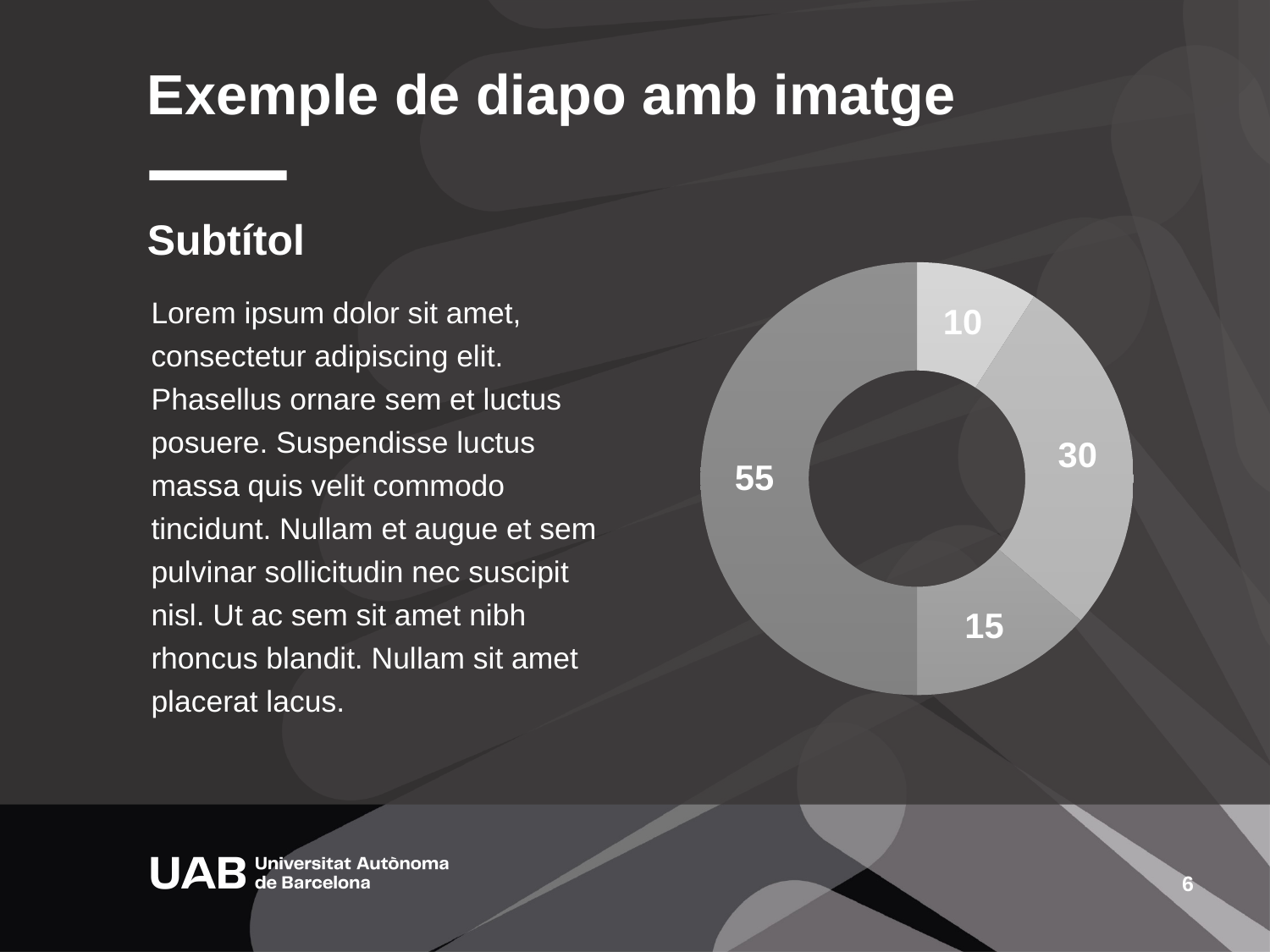
What kind of chart is shown on the slide? Doughnut (pie) chart Which is larger, the slice labelled 30 or the slice labelled 15? 30 What is the value shown on the slice on the left half of the doughnut chart? 55 What is the total of all the slice values in the doughnut chart? 110 How many slices does the doughnut chart have? 4 What is the value of the largest slice in the doughnut chart? 55 What is the difference between the slices labelled 30 and 15? 15 What share of the whole doughnut does the slice labelled 55 represent? 50% What is the value shown on the slice at the top of the doughnut chart, just right of the 12 o'clock position? 10 What is the value of the smallest slice in the doughnut chart? 10 What is the difference between the largest slice (55) and the smallest slice (10)? 45 What is the value shown on the slice at the bottom right of the doughnut chart? 15